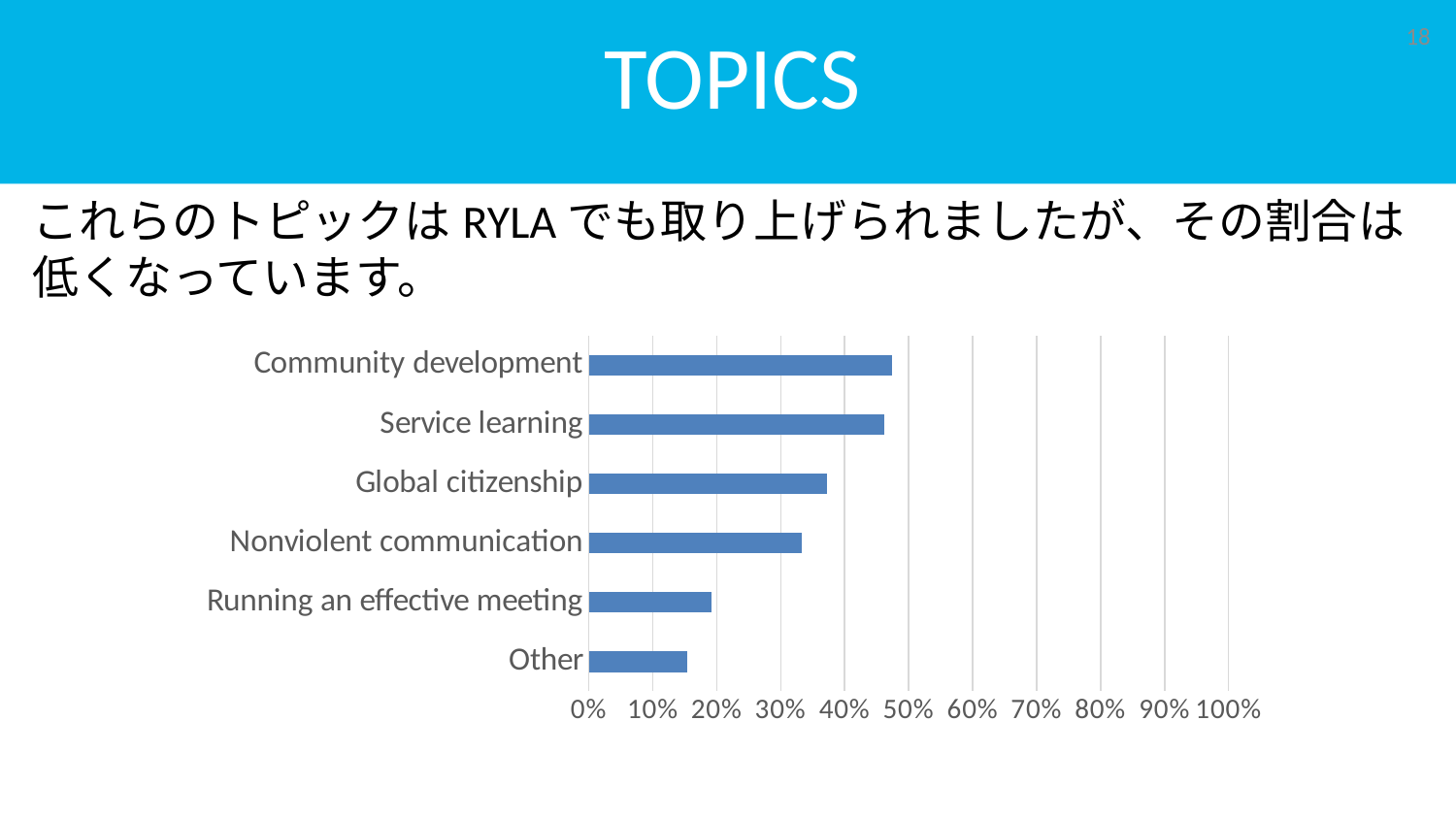
What kind of chart is shown on the slide? bar chart What is the highest value shown on the horizontal axis of the chart? 100% Is the value for Nonviolent communication greater or less than 30%? greater Which has a larger value, Service learning or Running an effective meeting? Service learning Is the value for Community development greater or less than 40%? greater Which category has the lowest value in the bar chart? Other Is the value for Service learning greater or less than 50%? less How many categories are plotted in the bar chart? 6 Which has a larger value, Global citizenship or Nonviolent communication? Global citizenship